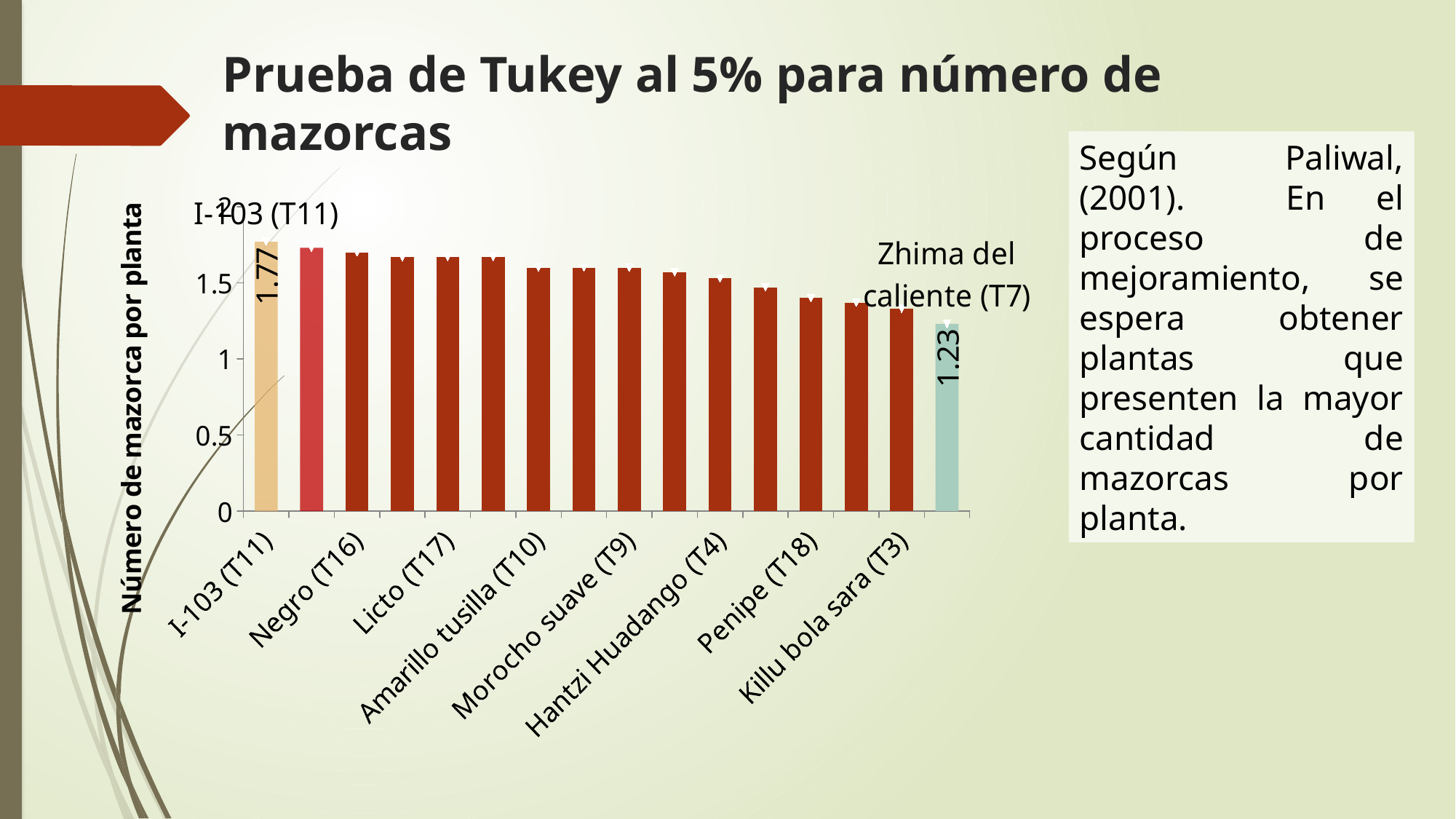
Is the value for Penipe (T18) greater or less than 1? greater Is the value for Killu bola sara (T3) greater or less than 1.5? less Which category has the highest number of mazorcas por planta? I-103 (T11) Do the values rise or fall from left to right along the x axis? Fall What is the value for I-103 (T11)? 1.77 Is the value for Negro (T16) greater or less than 1.5? greater Which is larger, the value for I-103 (T11) or the value for Zhima del caliente (T7)? I-103 (T11) How many bars are plotted in the chart? 16 What is the difference between the values for I-103 (T11) and Zhima del caliente (T7)? 0.54 What kind of chart is shown on the slide? Bar chart Which category has the lowest number of mazorcas por planta? Zhima del caliente (T7) What is the value for Zhima del caliente (T7)? 1.23